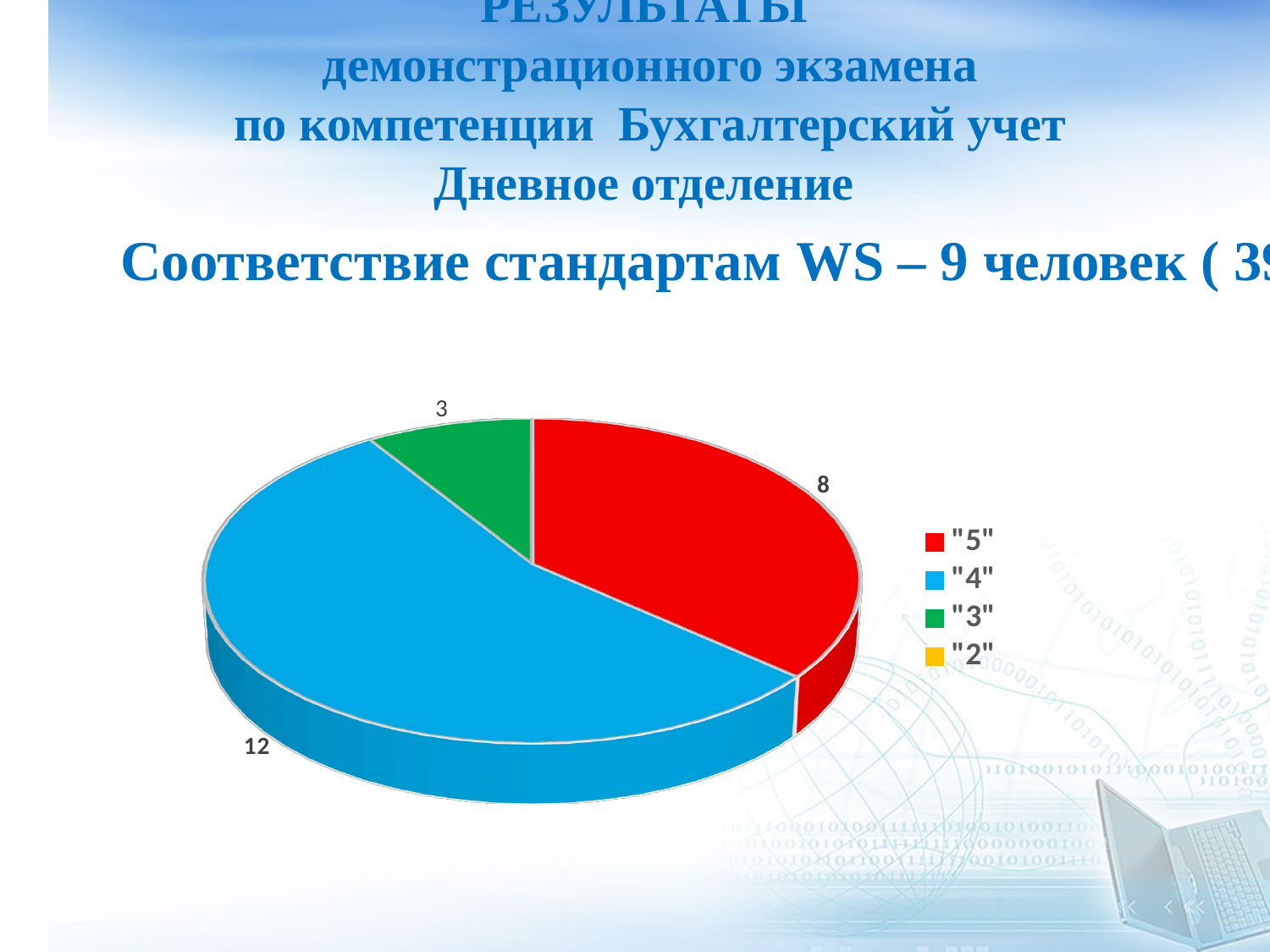
What is the difference between the values for "5" and "3"? 5 What colour is the "4" slice? blue What is the value for the "3" slice? 3 What type of chart is shown on the slide? pie chart Which labelled slice is the smallest? "3" How many categories does the legend list? 4 Which is larger, the value for "5" or the value for "3"? "5" What is the value for the "4" slice? 12 Which legend entry is shown in red? "5" What is the value for the "5" slice? 8 What is the difference between the values for "4" and "5"? 4 Which category has the largest slice? "4"